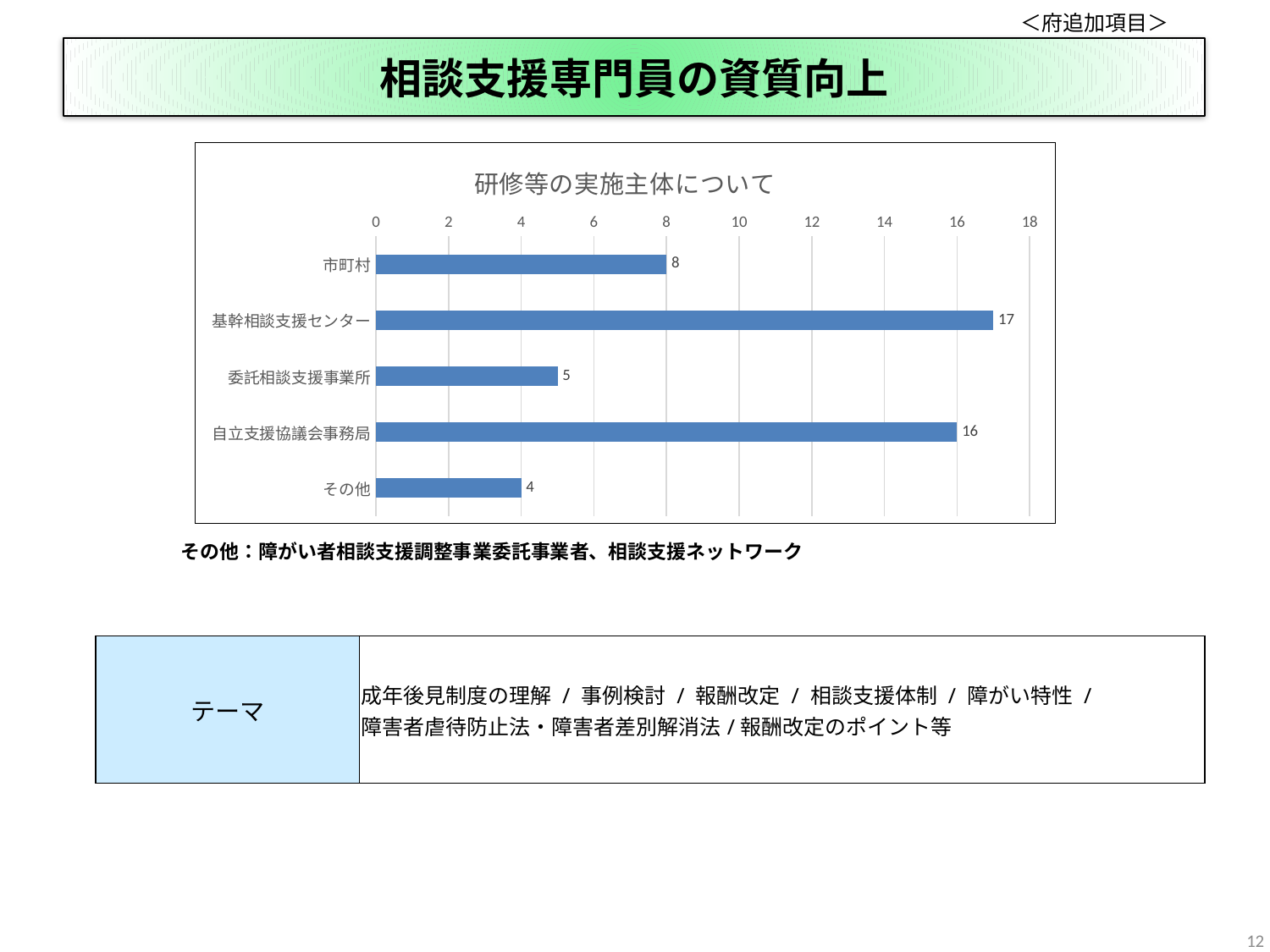
What is the value for 委託相談支援事業所? 5 What is the difference between the values for 基幹相談支援センター and 市町村? 9 Which category has the highest value? 基幹相談支援センター Which category has the lowest value? その他 Which is larger, the value for 市町村 or the value for 委託相談支援事業所? 市町村 How many categories are shown in the chart? 5 What is the value for 基幹相談支援センター? 17 What kind of chart is shown on the slide? Bar chart What is the value for 自立支援協議会事務局? 16 What is the value for 市町村? 8 What is the title of the chart? 研修等の実施主体について What is the value for その他? 4